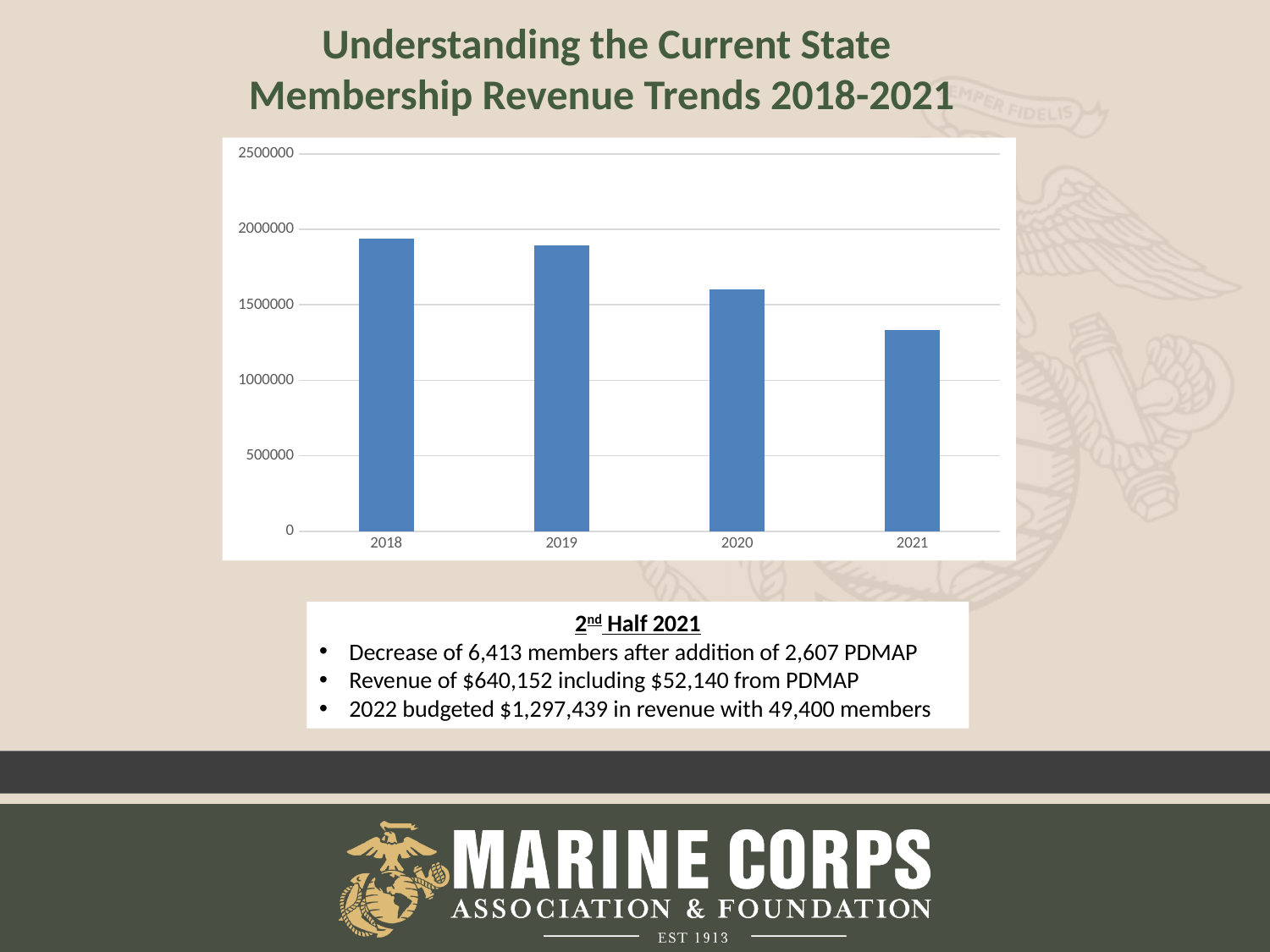
What kind of chart is shown on the slide? bar chart Is the value for 2018 greater or less than 2000000? less Which year has the lowest membership revenue on the chart? 2021 Which is larger, the value for 2020 or the value for 2021? 2020 What is the highest value shown on the vertical axis of the chart? 2500000 Is the value for 2020 greater or less than 1500000? greater Is the value for 2019 greater or less than 1500000? greater How many years are plotted on the chart? 4 Do the values rise or fall from 2018 to 2021 along the x axis? fall Which year has the highest membership revenue on the chart? 2018